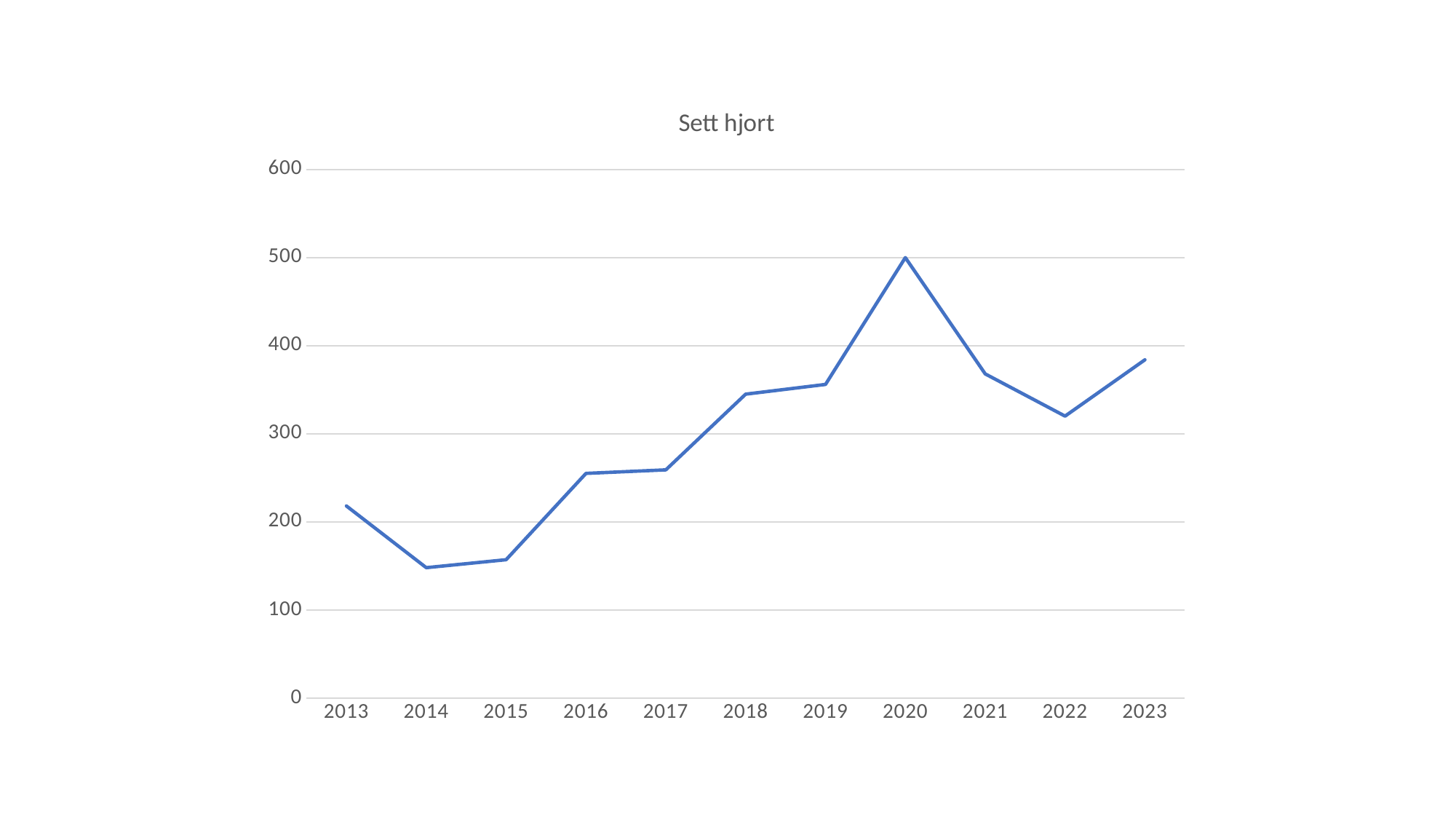
Is the value for 2013 greater or less than 200? greater Which year has the lowest value? 2014 What is the value for 2020? 500 How many years are plotted along the x axis? 11 Do the values rise or fall from 2015 to 2020? rise What kind of chart is shown on the slide? line chart Is the value for 2023 greater or less than 400? less What is the title of the chart? Sett hjort Is the value for 2015 greater or less than 200? less Which is larger, the value for 2021 or the value for 2022? 2021 Which year has the highest value? 2020